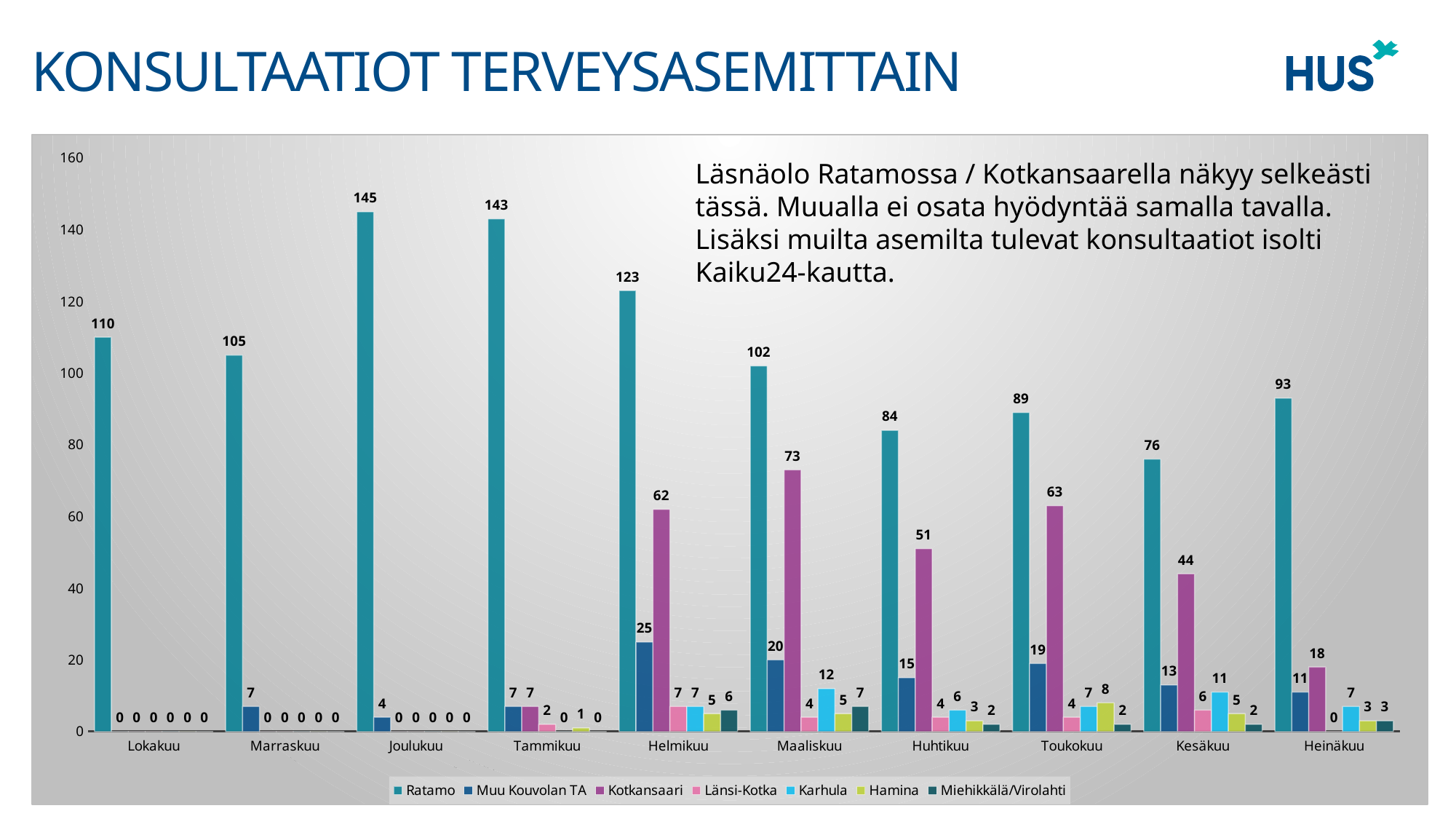
How many months are shown on the x axis? 10 Which is larger in Toukokuu: the Ratamo value or the Kotkansaari value? Ratamo What is the title of the slide? KONSULTAATIOT TERVEYSASEMITTAIN What kind of chart is shown on the slide? Bar chart What is the value for Muu Kouvolan TA in Helmikuu? 25 How many series does the legend list? 7 What is the difference between the Ratamo values in Joulukuu and Tammikuu? 2 In which month is the Ratamo value lowest? Kesäkuu What is the value for Kotkansaari in Maaliskuu? 73 What is the value for Karhula in Kesäkuu? 11 What is the value for Ratamo in Joulukuu? 145 In which month is the Ratamo value highest? Joulukuu